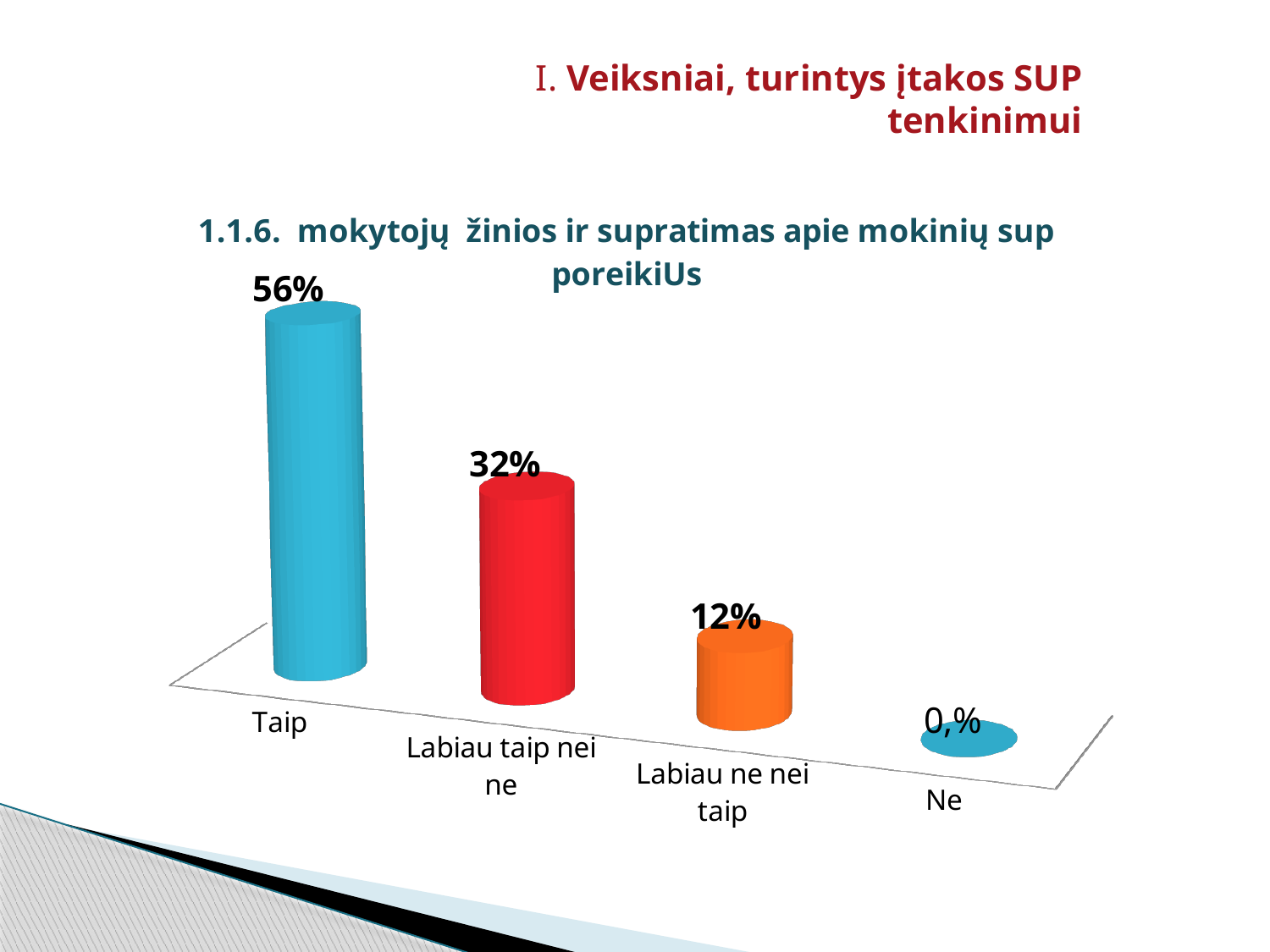
Do the values rise or fall from left to right along the x axis? Fall What is the difference between the values for Taip and Labiau taip nei ne? 24% Which is larger, the value for Labiau taip nei ne or the value for Labiau ne nei taip? Labiau taip nei ne Which category has the lowest value? Ne What kind of chart is shown on the slide? Bar chart How many categories are shown in the chart? 4 What is the value for Ne? 0,% What is the difference between the values for Labiau taip nei ne and Labiau ne nei taip? 20% Which category has the highest value? Taip What is the value for Labiau ne nei taip? 12% What is the value for Taip? 56% What is the value for Labiau taip nei ne? 32%